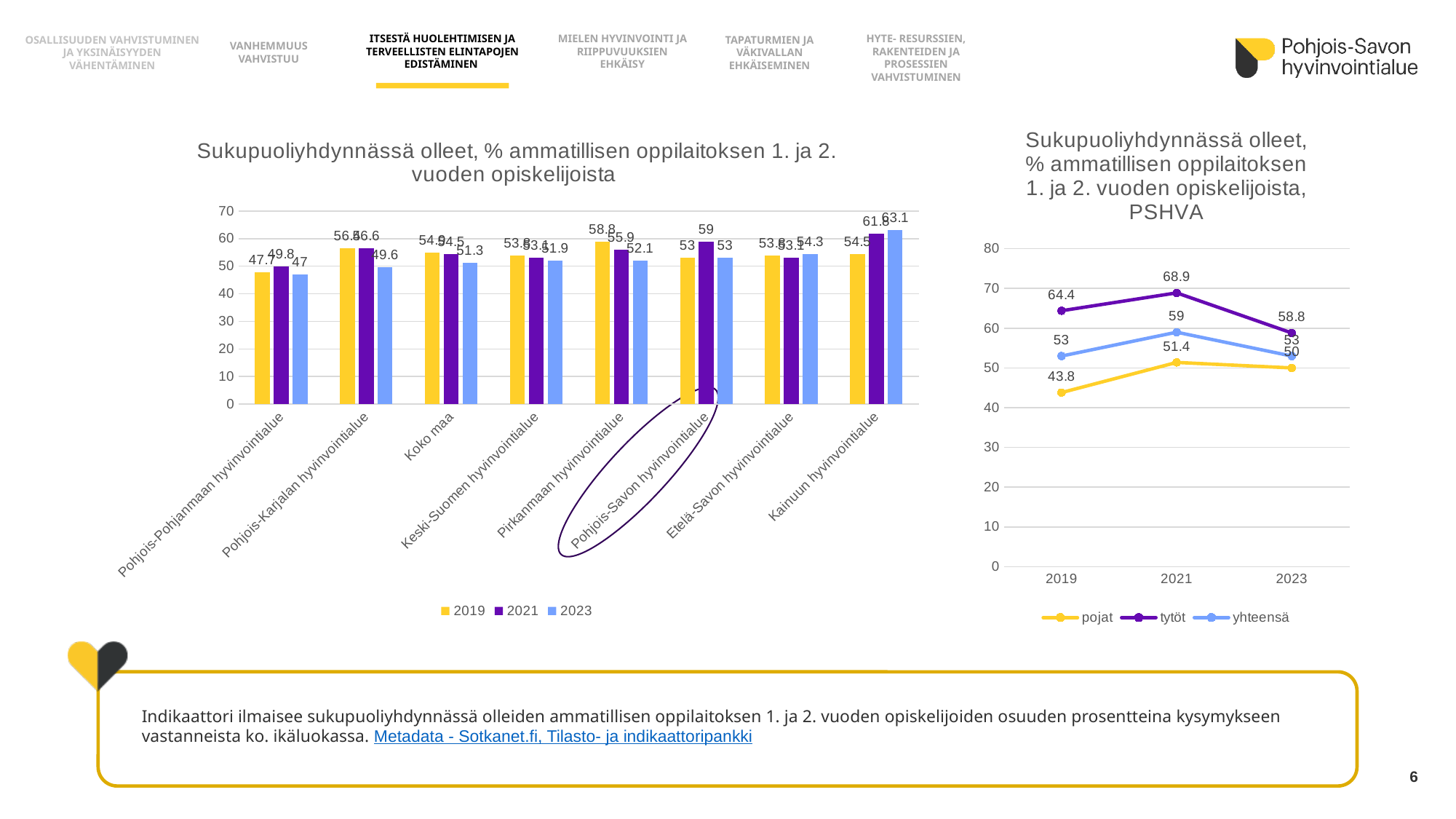
In the left chart, how many series does the legend list? 3 In the left chart, what is the 2023 value for Kainuun hyvinvointialue? 63.1 In the right chart (PSHVA), what is the value for tytöt in 2021? 68.9 What kind of chart is the right chart (PSHVA)? Line chart In the left chart, how many categories are shown on the x axis? 8 In the left chart, which category has the highest 2023 value? Kainuun hyvinvointialue In the left chart, what is the 2019 value for Pirkanmaan hyvinvointialue? 58.8 In the right chart (PSHVA), what is the value for pojat in 2019? 43.8 In the left chart, what is the 2021 value for Pohjois-Savon hyvinvointialue? 59 In the right chart (PSHVA), what is the difference between tytöt and pojat in 2023? 8.8 In the left chart, which category has the lowest 2019 value? Pohjois-Pohjanmaan hyvinvointialue In the left chart, what is the difference between the 2021 and 2023 values for Pirkanmaan hyvinvointialue? 3.8